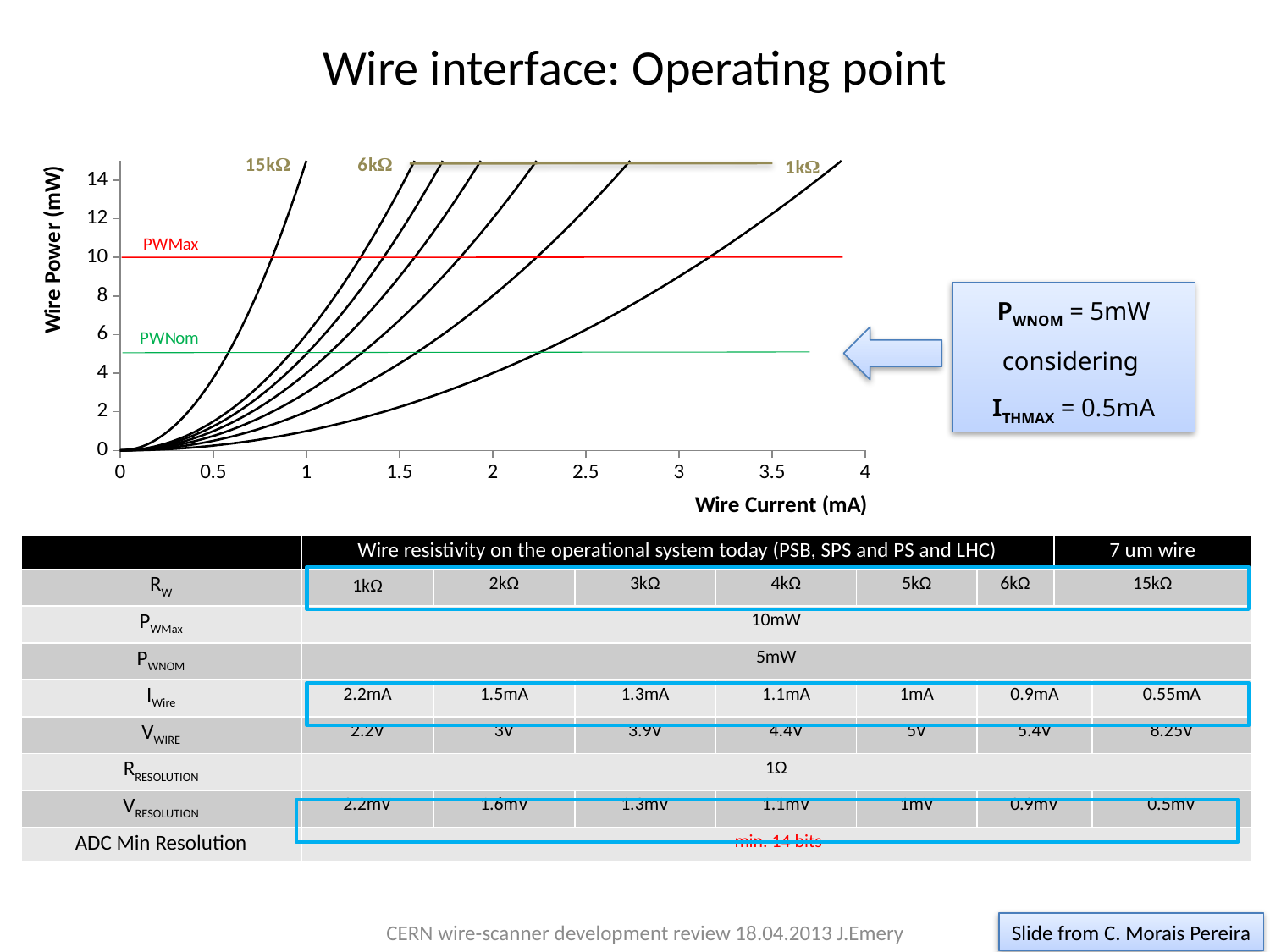
Which labelled resistance curve rises most steeply with wire current? 15kΩ Which labelled resistance curve reaches the PWMax line at the highest wire current? 1kΩ Which horizontal reference line is at a higher power, PWMax or PWNom? PWMax At what wire power level is the PWNom line drawn? 5 What is the label of the x axis of the chart? Wire Current (mA) What is the label of the y axis of the chart? Wire Power (mW) What kind of chart is shown on the slide? line chart At what wire power level is the PWMax line drawn? 10 Does wire power rise or fall as wire current increases along each resistance curve? rise Is the wire current at which the 15kΩ curve crosses the PWMax line greater or less than 1 mA? less Is the wire current at which the 1kΩ curve crosses the PWMax line greater or less than 2.5 mA? greater What is the difference in wire power between the PWMax line and the PWNom line? 5